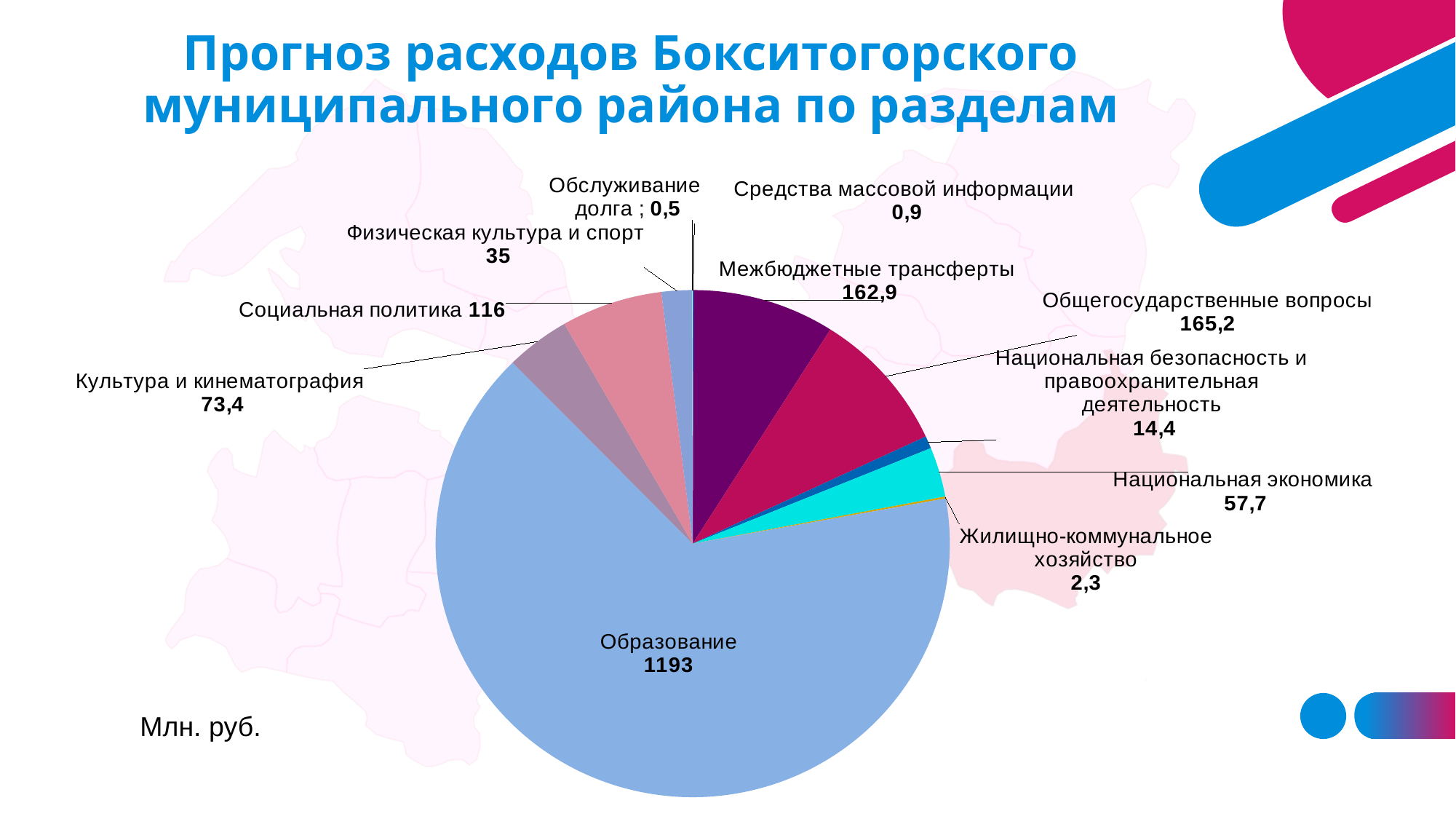
Which is larger: Социальная политика or Культура и кинематография? Социальная политика What type of chart is shown on the slide? Pie chart What is the difference between Общегосударственные вопросы and Межбюджетные трансферты? 2,3 What is the value shown for Национальная безопасность и правоохранительная деятельность? 14,4 Which section has the largest forecast expenditure? Образование Which section has the smallest forecast expenditure? Обслуживание долга How many sections (slices) are shown in the pie chart? 11 What is the difference between Образование and Социальная политика? 1077 What is the value shown for Жилищно-коммунальное хозяйство? 2,3 In what units are the values on the chart expressed? Млн. руб. What is the value shown for Межбюджетные трансферты? 162,9 What is the forecast expenditure for Образование? 1193